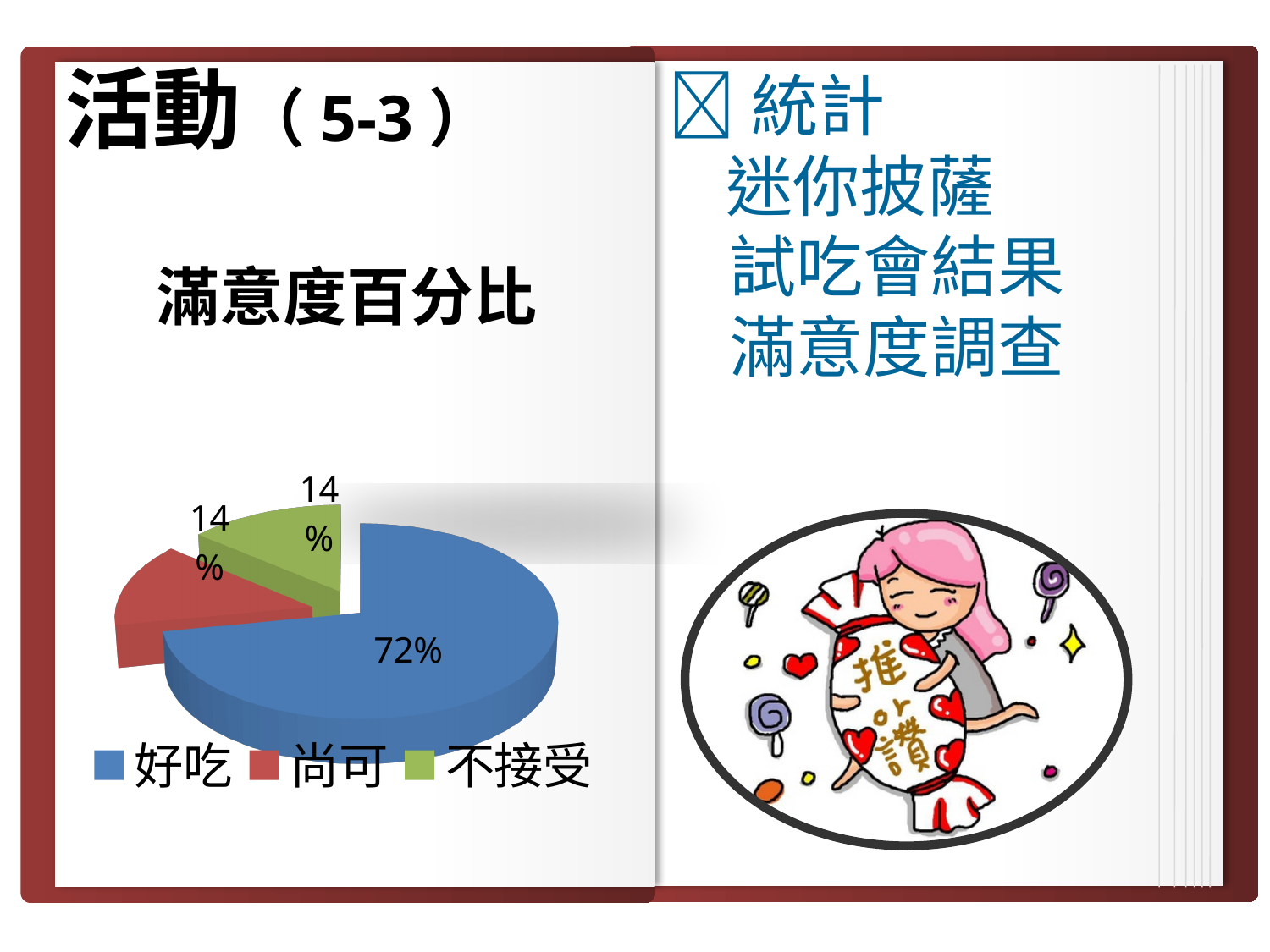
What percentage of the pie is labelled 不接受? 14% Which is larger, the share for 好吃 or the share for 不接受? 好吃 What colour is the 好吃 slice in the pie chart? blue What type of chart is shown on the slide? pie chart What is the title of the chart? 滿意度百分比 What percentage of the pie is labelled 尚可? 14% What is the combined share of 尚可 and 不接受? 28% What percentage of the pie is labelled 好吃? 72% Which category has the largest slice of the pie? 好吃 How many categories does the legend list? 3 What is the difference between the 好吃 share and the 尚可 share? 58%